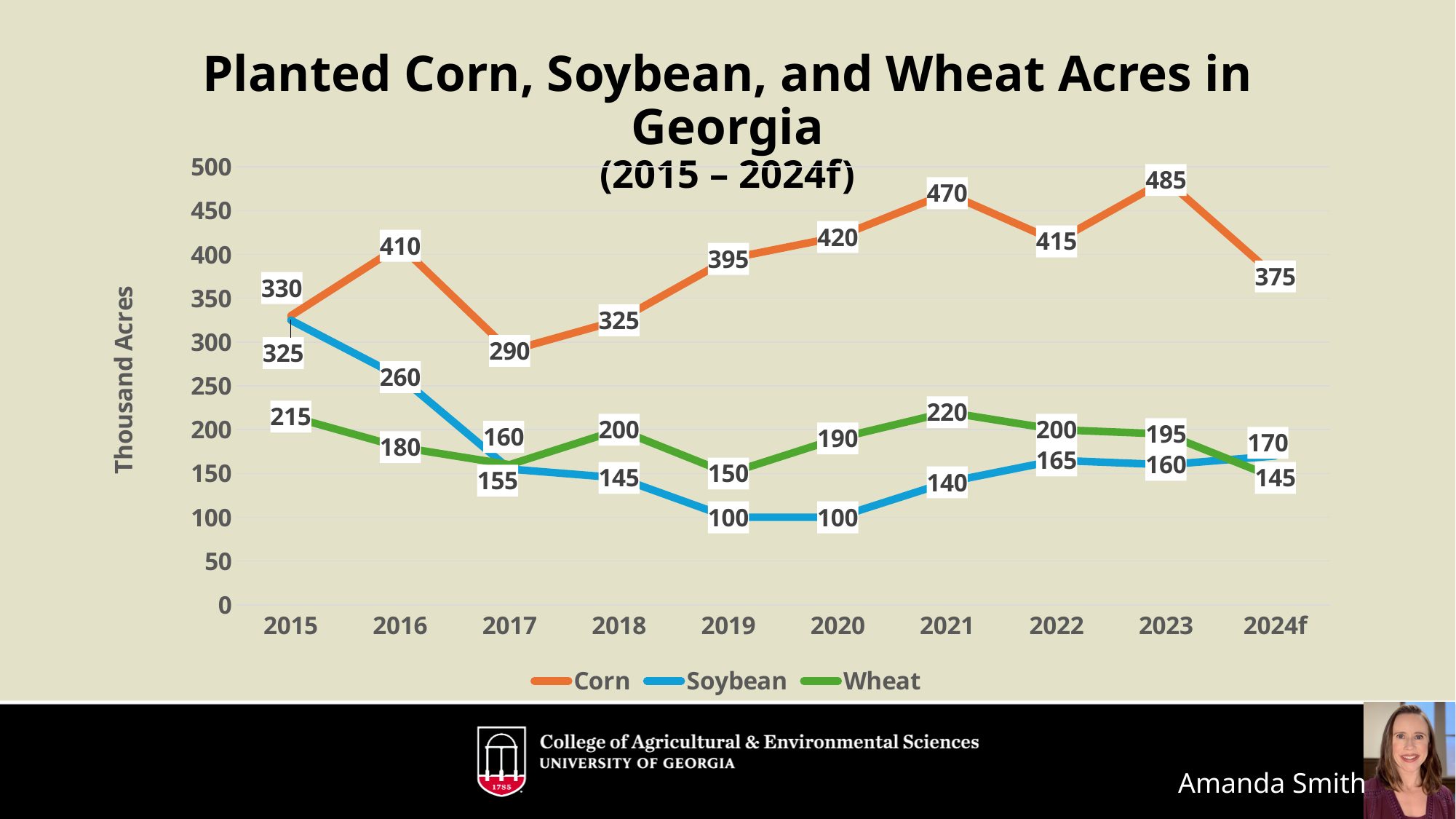
What type of chart is shown on the slide? Line chart In which year is the Corn value highest? 2023 What is the value for Corn in 2023? 485 What is the difference between the Corn value in 2023 and the Corn value in 2024f? 110 Does the Soybean value rise or fall from 2015 to 2019? Fall How many years are plotted along the x axis? 10 In which year is the Corn value lowest? 2017 What is the value for Wheat in 2021? 220 Which is larger in 2024f, the Soybean value or the Wheat value? Soybean What is the label on the vertical axis? Thousand Acres What is the value for Soybean in 2016? 260 How many series does the legend list? 3